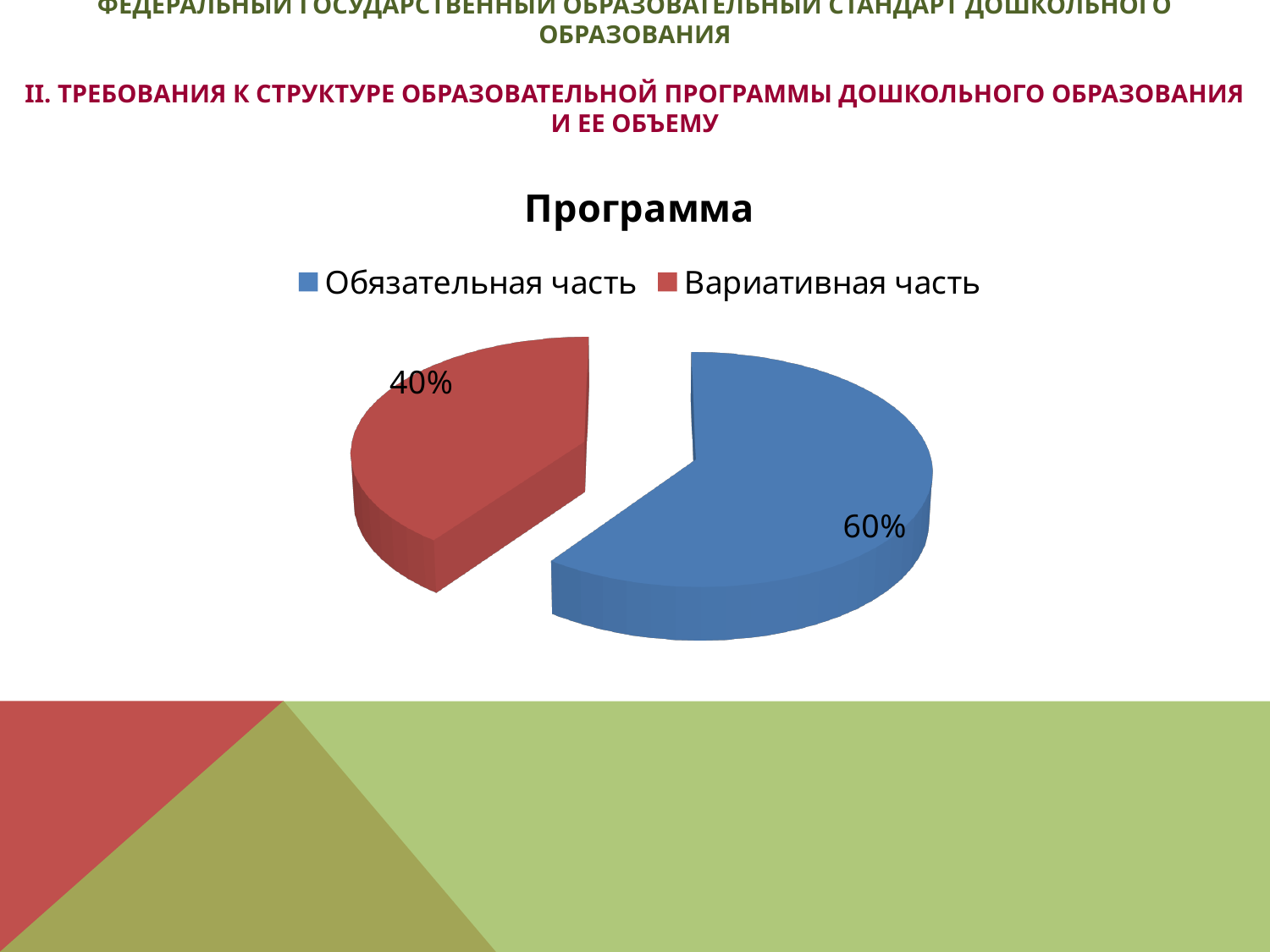
How many slices does the pie chart have? 2 Which slice is the smallest? Вариативная часть What is the title of the chart? Программа What colour is the Вариативная часть slice? red What share of the pie does Обязательная часть take? 60% What kind of chart is shown on the slide? pie chart Which slice is the largest? Обязательная часть Which is larger, Обязательная часть or Вариативная часть? Обязательная часть Is the share for Обязательная часть greater or less than 50%? greater How many entries does the legend list? 2 What is the difference between the shares of Обязательная часть and Вариативная часть? 20% What share of the pie does Вариативная часть take? 40%